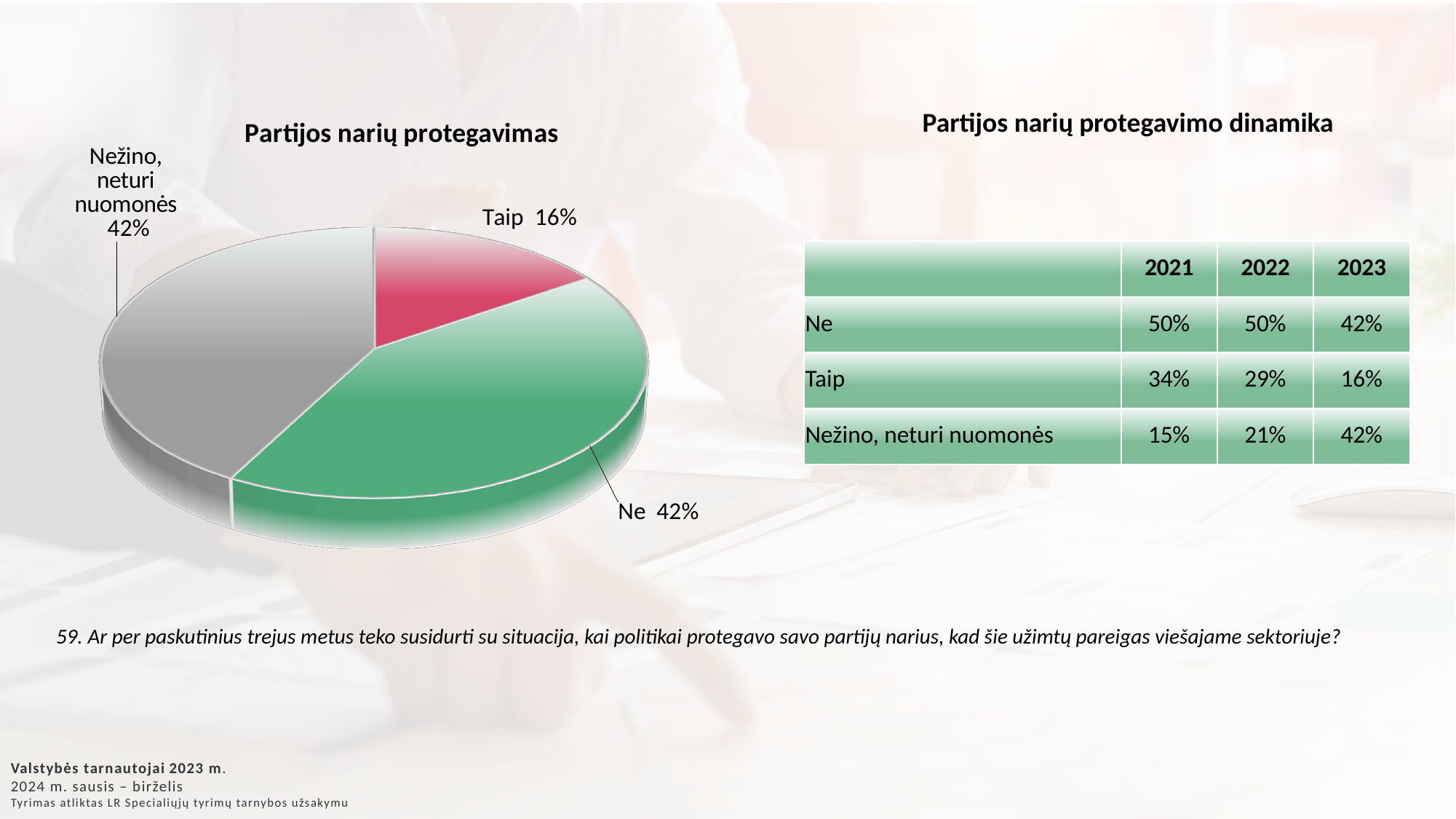
In the pie chart "Partijos narių protegavimas", what is the difference in percentage points between "Ne" and "Taip"? 26 percentage points In the pie chart "Partijos narių protegavimas", which category has the smallest slice? Taip In the pie chart "Partijos narių protegavimas", what is the value for "Ne"? 42% In the pie chart "Partijos narių protegavimas", what colour is the "Taip" slice? red What kind of chart is shown under the title "Partijos narių protegavimas"? pie chart In the pie chart "Partijos narių protegavimas", which is larger: "Taip" or "Ne"? Ne What is the title of the pie chart on the left of the slide? Partijos narių protegavimas In the pie chart "Partijos narių protegavimas", what is the value for "Nežino, neturi nuomonės"? 42% In the pie chart "Partijos narių protegavimas", what share does the "Taip" slice have? 16% How many slices does the pie chart "Partijos narių protegavimas" have? 3 In the pie chart "Partijos narių protegavimas", is the value for "Taip" greater or less than 20%? less